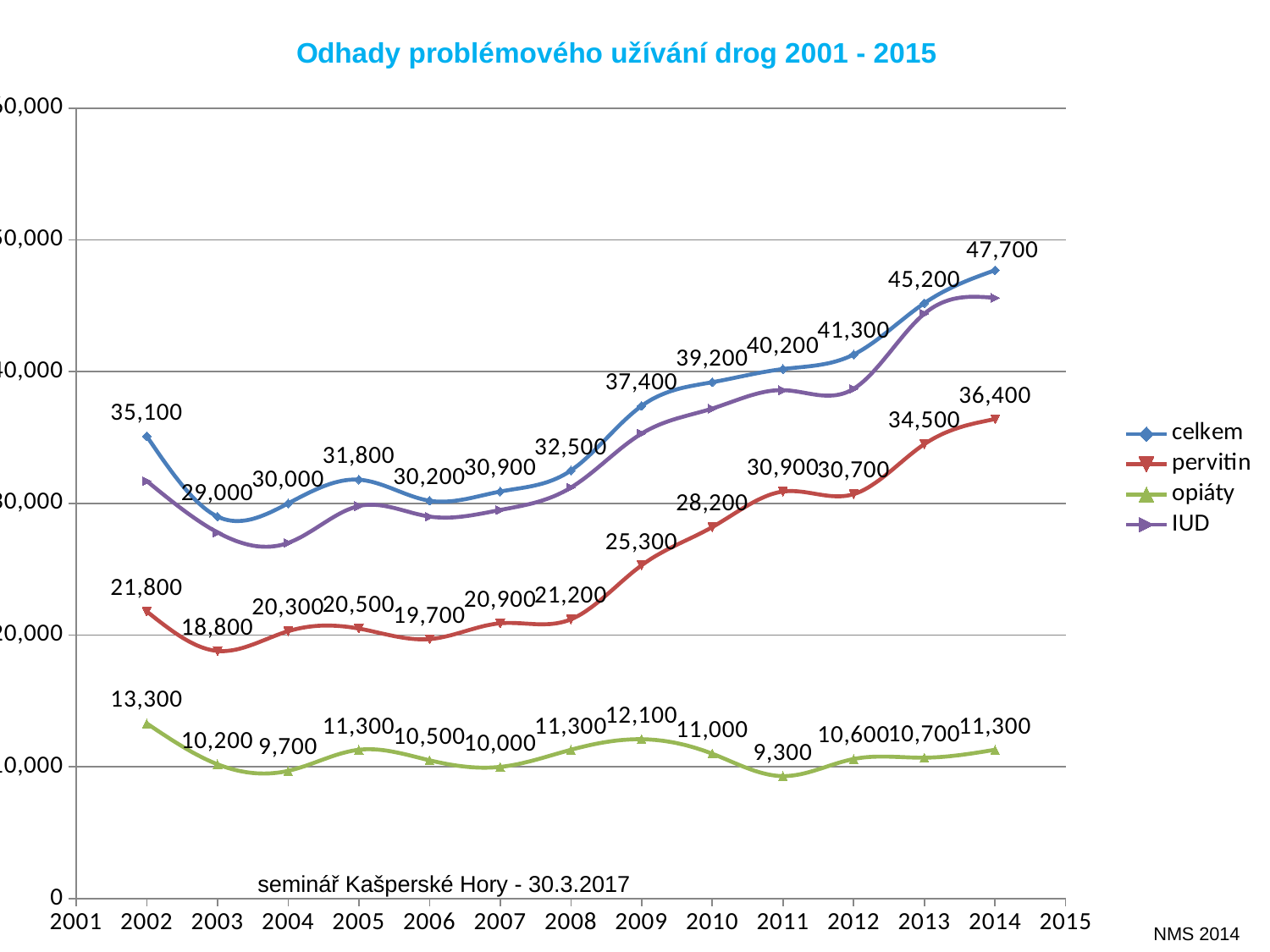
What is the title of the chart? Odhady problémového užívání drog 2001 - 2015 What is the value for pervitin in 2009? 25,300 Is the IUD value in 2014 greater or less than 40,000? greater What kind of chart is shown on the slide? line chart What is the value for celkem in 2014? 47,700 In which year is the celkem series lowest? 2003 What is the value for opiáty in 2011? 9,300 What is the difference between the celkem values in 2014 and 2002? 12,600 Does the pervitin series rise or fall between 2008 and 2014? rise In which year is the opiáty series highest? 2002 Which is larger, the pervitin value in 2011 or in 2012? 2011 How many series does the legend list? 4